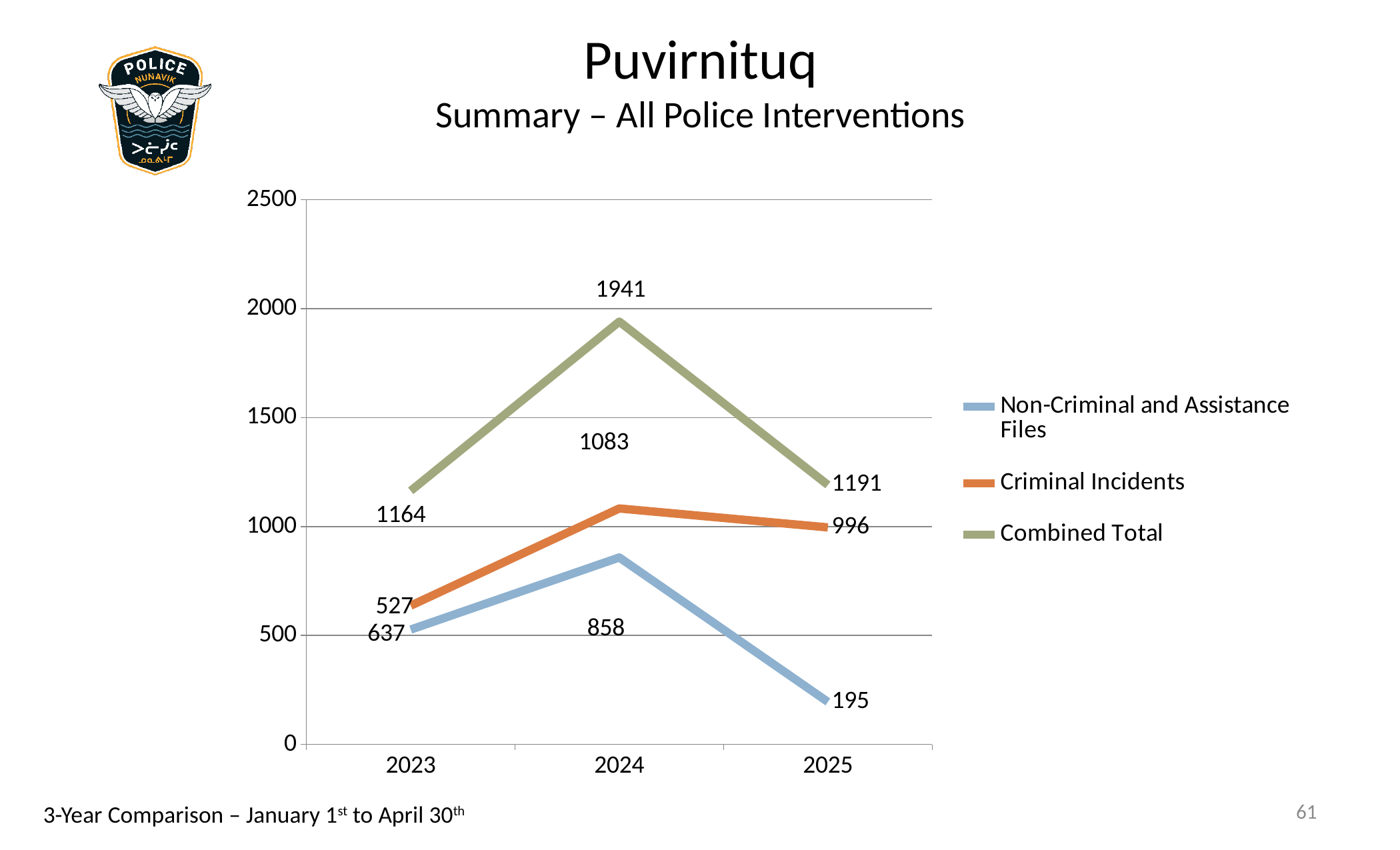
In which year is the value for Non-Criminal and Assistance Files lowest? 2025 What kind of chart is shown on the slide? Line chart What is the subtitle of the chart shown on the slide? Summary – All Police Interventions How many series does the legend list? 3 What is the value for Non-Criminal and Assistance Files in 2025? 195 What is the value for Criminal Incidents in 2024? 1083 What is the Combined Total value for 2024? 1941 Does the Non-Criminal and Assistance Files line rise or fall from 2024 to 2025? Fall Which year has the larger value for Criminal Incidents, 2023 or 2025? 2025 What is the difference between the Combined Total in 2024 and in 2025? 750 In which year is the Combined Total highest? 2024 How many years are plotted along the x axis? 3